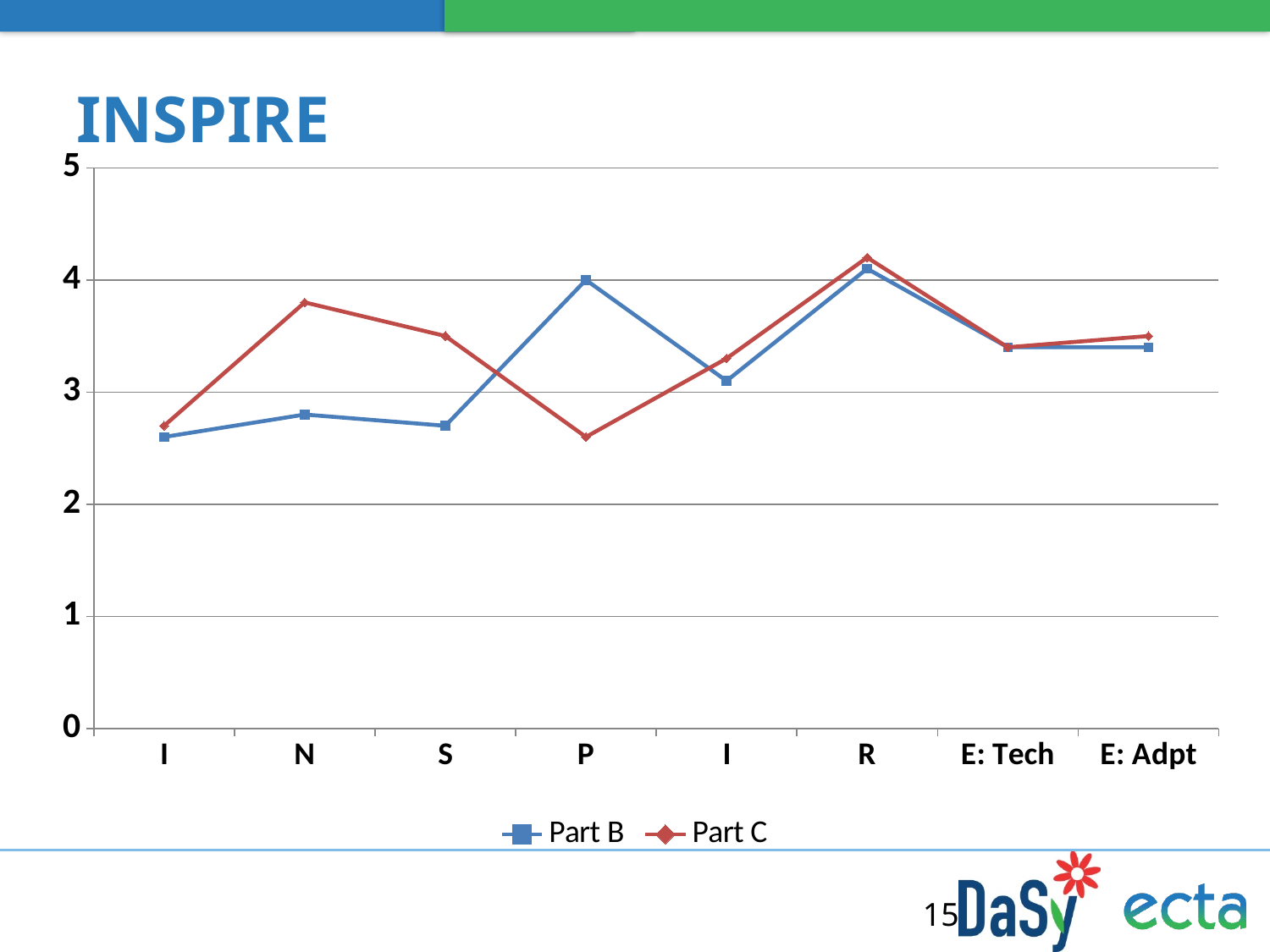
How many categories are shown along the x axis? 8 At N, which series has the larger value, Part B or Part C? Part C Which series is drawn in blue with square markers? Part B Is the value for Part C at N greater or less than 3? greater What kind of chart is shown on the slide? line chart At P, which series has the larger value, Part B or Part C? Part B Is the value for Part B at S greater or less than 3? less How many series does the legend list? 2 What is the title of the chart? INSPIRE For which category does Part C reach its highest value? R Is the value for Part C at P greater or less than 3? less